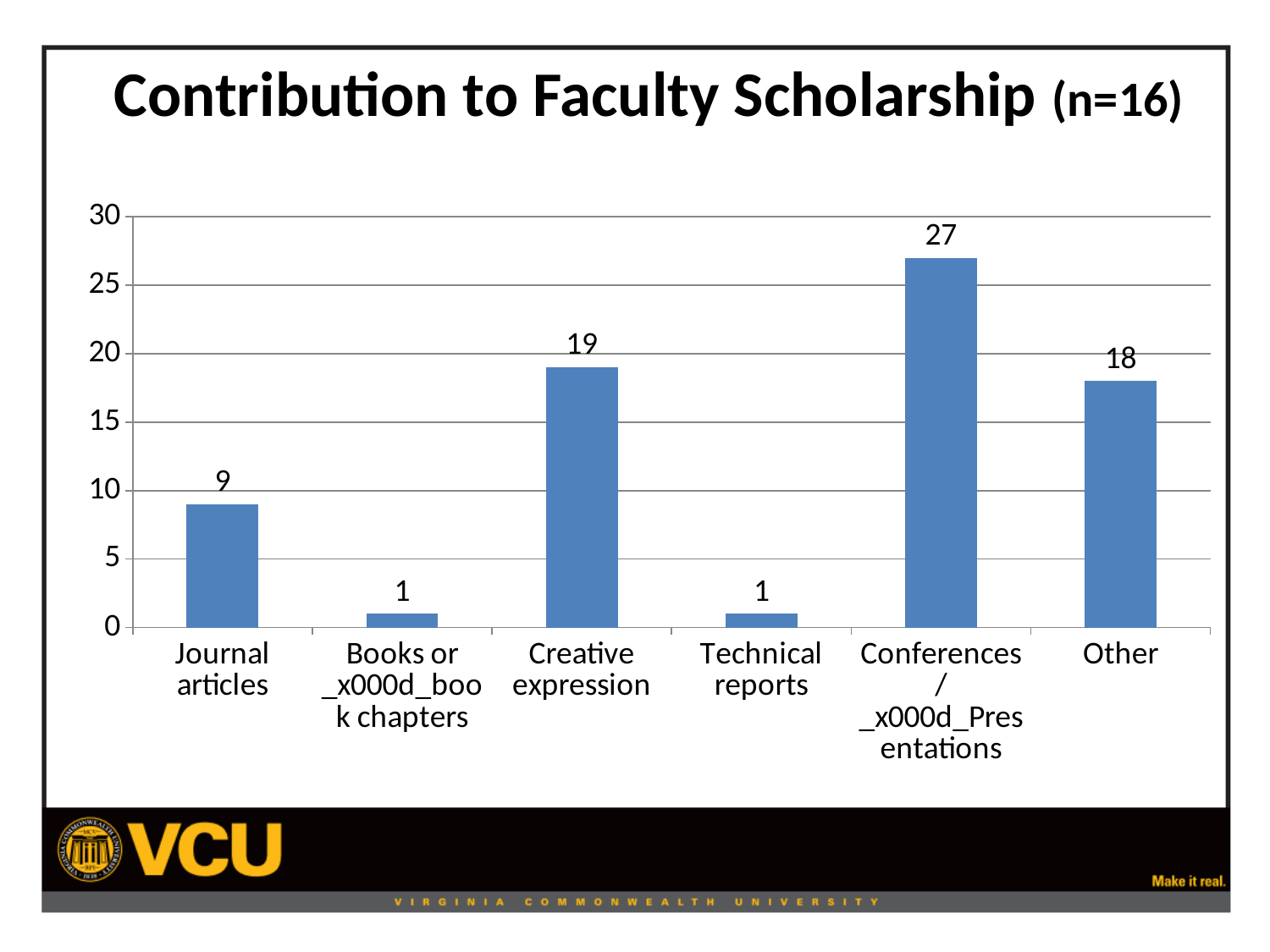
Which category has the highest value? Conferences / Presentations What is the value for Creative expression? 19 Which is larger, the value for Creative expression or the value for Other? Creative expression What is the title of the chart? Contribution to Faculty Scholarship (n=16) What is the value for Journal articles? 9 How many categories are shown on the x axis? 6 What is the value for Conferences / Presentations? 27 What is the value for Other? 18 What kind of chart is shown on the slide? bar chart Is the value for Journal articles greater or less than 10? less What is the value for Technical reports? 1 What is the difference between the values for Conferences / Presentations and Creative expression? 8